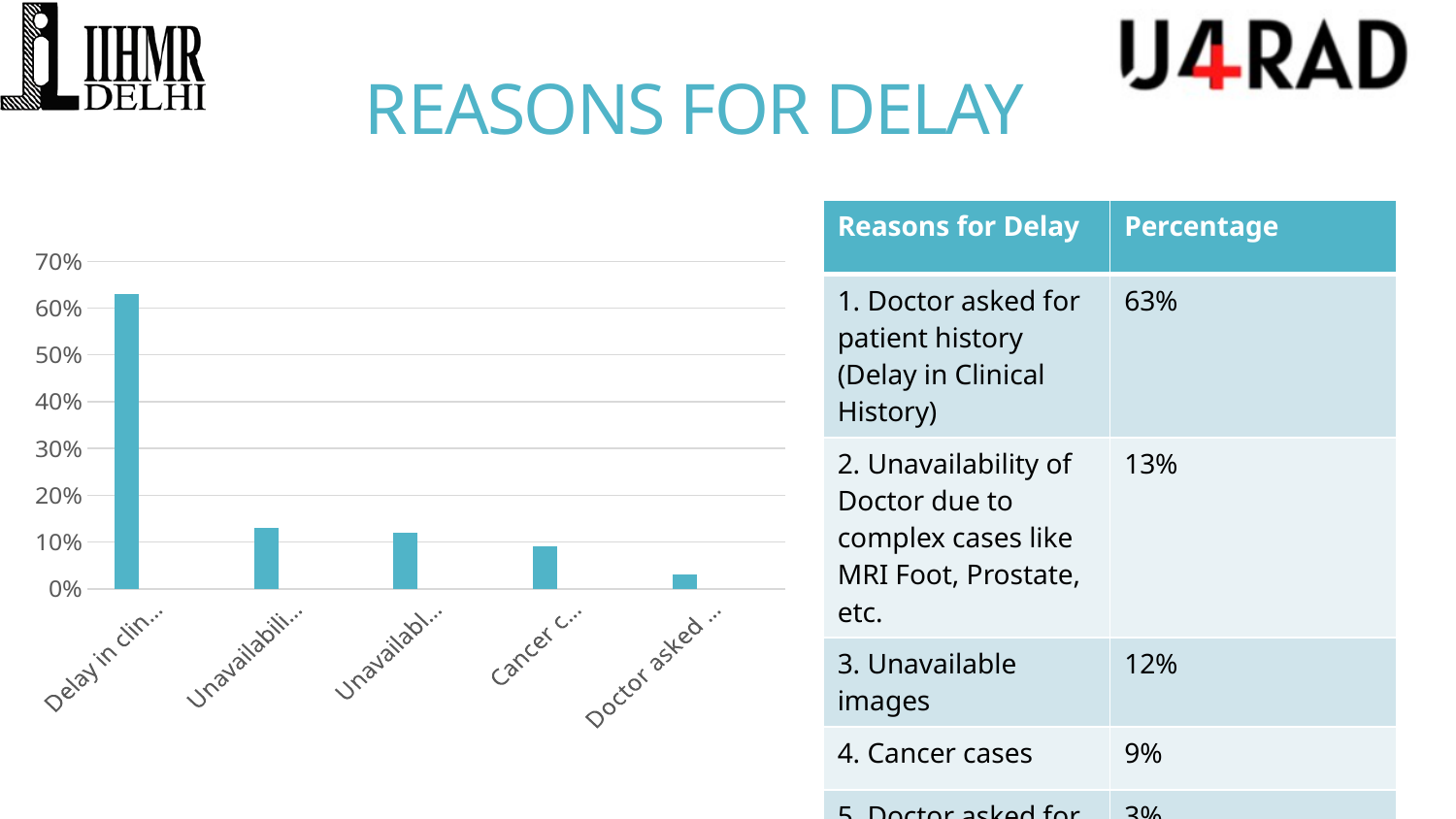
Which is larger: the bar for Delay in clin... or the bar for Cancer c...? Delay in clin... What kind of chart is shown on the slide? bar chart Using the percentages in the table, what is the difference between Delay in Clinical History (63%) and Unavailability of Doctor (13%)? 50 percentage points Which category has the lowest bar in the chart? Doctor asked ... (last bar) According to the table on the slide, what percentage corresponds to Delay in Clinical History? 63% Which category has the highest bar in the chart? Delay in clinical history (first bar) Is the value for the first bar (Delay in clin...) greater or less than 60%? greater How many bars (categories) does the chart show? 5 Is the value for the Cancer c... bar greater or less than 20%? less Is the value for the last bar (Doctor asked ...) greater or less than 10%? less Do the bar values rise or fall from left to right across the chart? fall According to the table on the slide, what percentage corresponds to Unavailable images? 12%